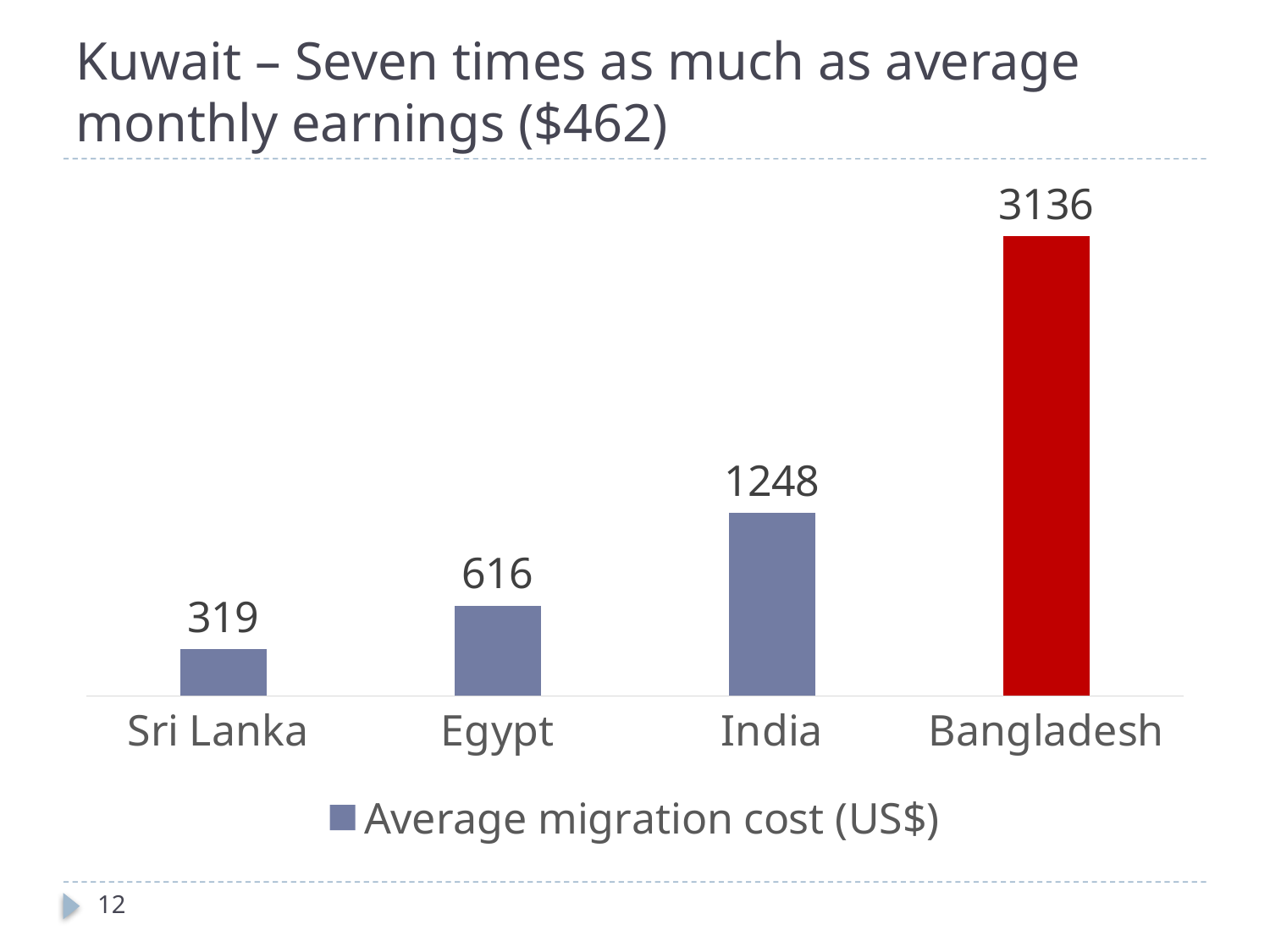
Which has a higher average migration cost, India or Egypt? India What is the average migration cost for Bangladesh? 3136 Which country has the lowest average migration cost? Sri Lanka Which bar is coloured red in the chart? Bangladesh What is the average migration cost for Egypt? 616 What is the difference between the average migration cost for Bangladesh and India? 1888 What is the difference between the average migration cost for Egypt and Sri Lanka? 297 What is the average migration cost for India? 1248 What kind of chart is shown on the slide? Bar chart Which country has the highest average migration cost? Bangladesh How many countries are shown in the chart? 4 What is the average migration cost for Sri Lanka? 319